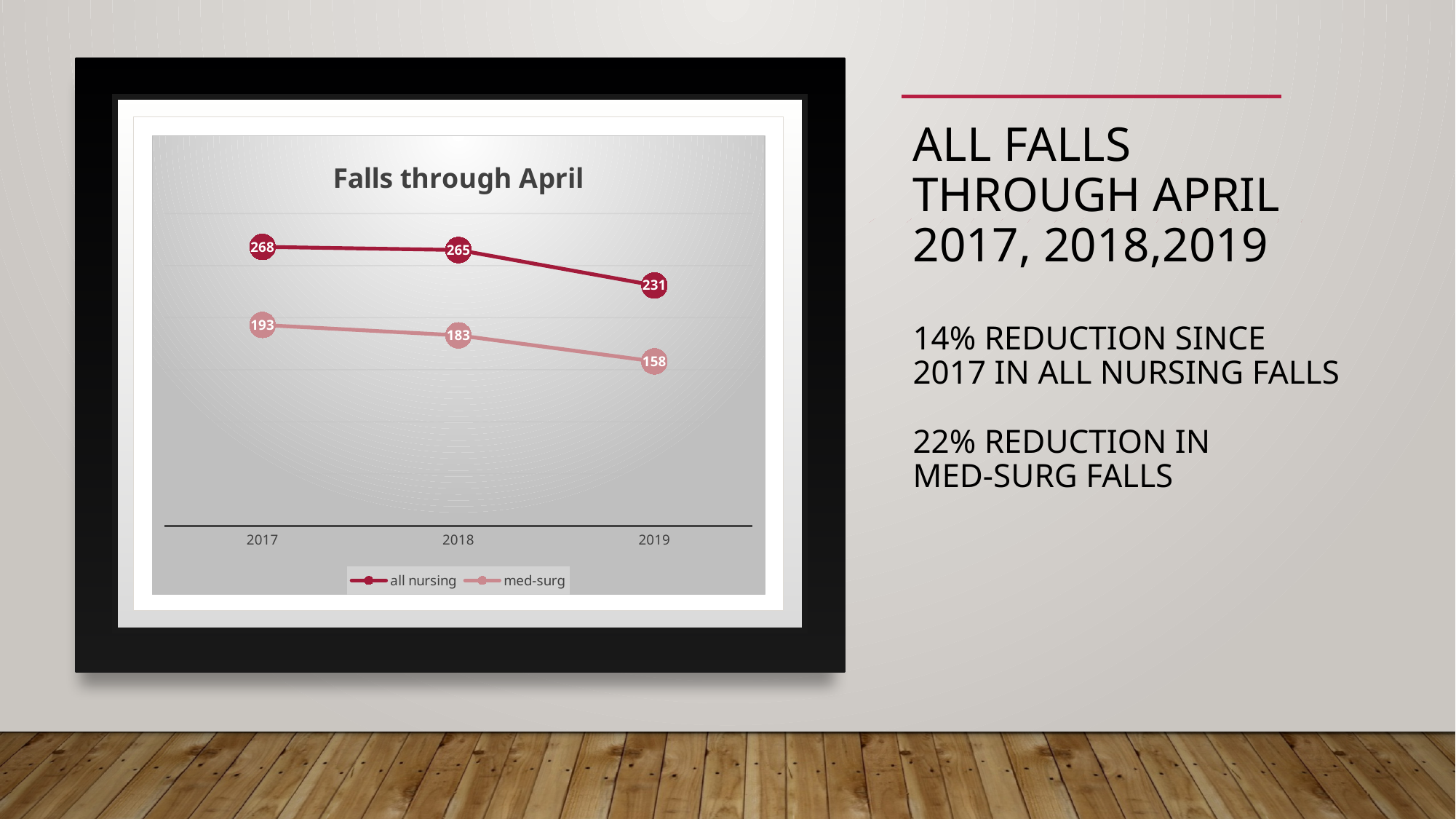
What is the difference between the all nursing value in 2017 and in 2019? 37 How many series does the legend list? 2 What kind of chart is shown? line chart In which year is the all nursing value lowest? 2019 How many years are shown on the x axis? 3 What is the difference between the all nursing and med-surg values in 2019? 73 In which year is the med-surg value highest? 2017 What is the value for med-surg in 2018? 183 What is the value for all nursing in 2018? 265 What is the value for all nursing in 2017? 268 What is the value for med-surg in 2019? 158 Which is larger in 2018, the all nursing value or the med-surg value? all nursing